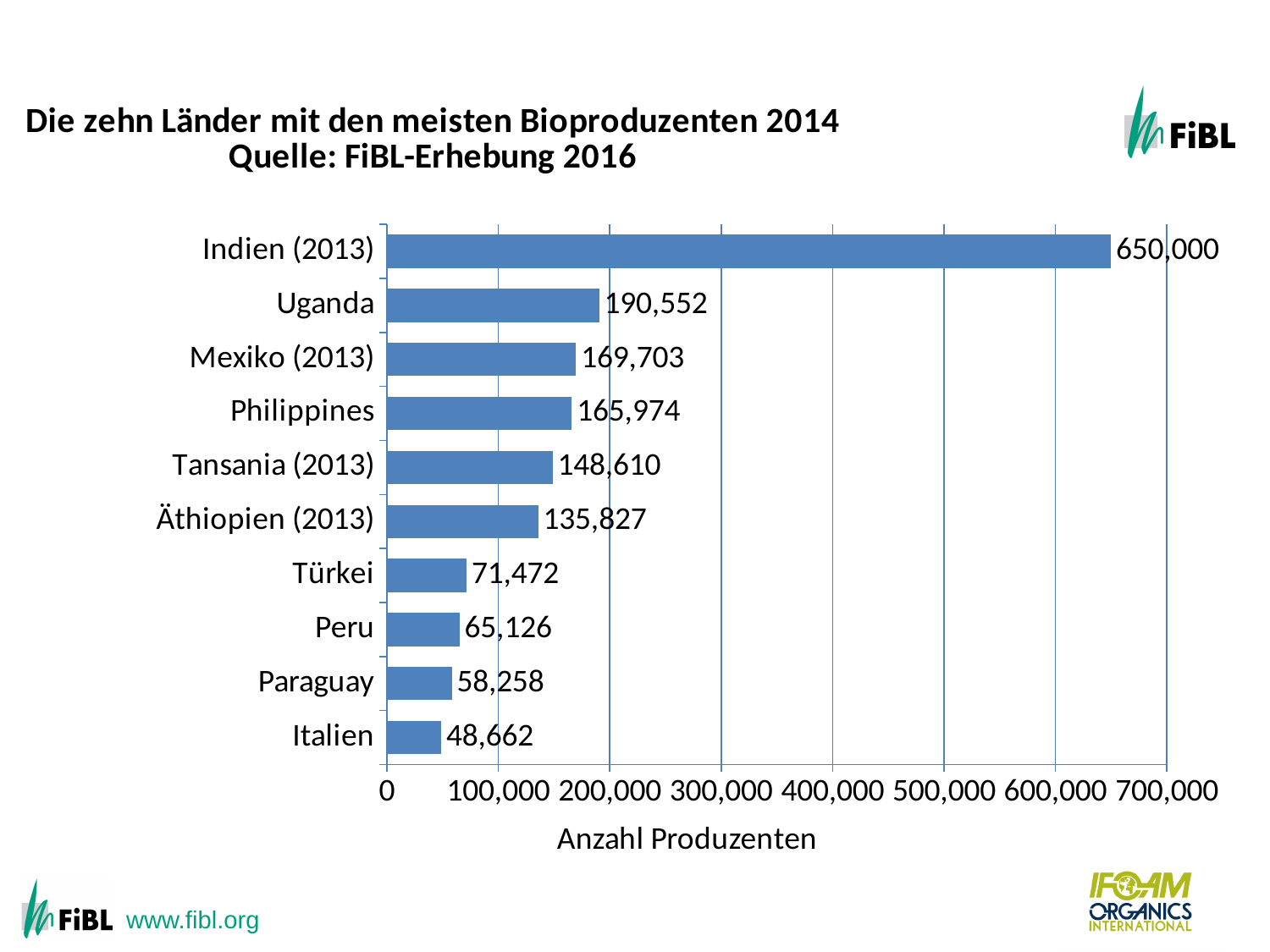
Which has more producers, Mexiko (2013) or Äthiopien (2013)? Mexiko (2013) What is the difference in producers between Türkei and Peru? 6,346 What is the label of the horizontal axis? Anzahl Produzenten What kind of chart is shown on the slide? bar chart What is the difference in producers between Indien (2013) and Uganda? 459,448 Is the value for Philippines greater or less than 200,000? less What is the number of producers for Uganda? 190,552 What is the number of producers for Tansania (2013)? 148,610 Which country has the highest number of producers? Indien (2013) How many countries are shown in the chart? 10 Which country has the lowest number of producers? Italien What is the number of producers for Italien? 48,662